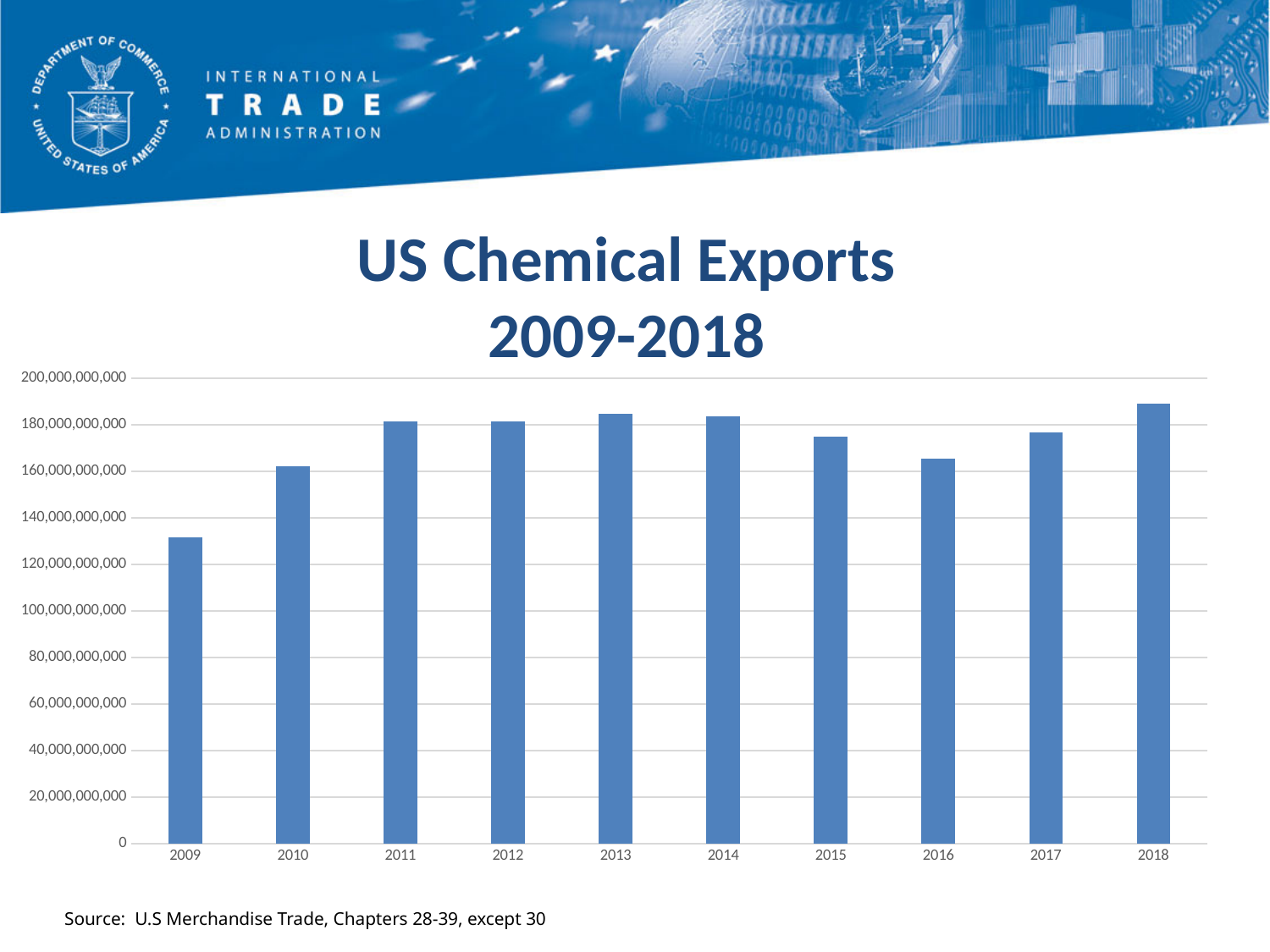
What kind of chart is shown on the slide? bar chart Is the value for 2015 greater or less than 180,000,000,000? less Is the value for 2009 greater or less than 140,000,000,000? less What source is cited below the chart? U.S Merchandise Trade, Chapters 28-39, except 30 Is the value for 2018 greater or less than 180,000,000,000? greater How many years are plotted on the chart? 10 Which year has the highest US chemical exports? 2018 Which is larger, the value for 2015 or the value for 2016? 2015 Which is larger, the value for 2009 or the value for 2010? 2010 What is the title of the chart? US Chemical Exports 2009-2018 Which year has the lowest US chemical exports? 2009